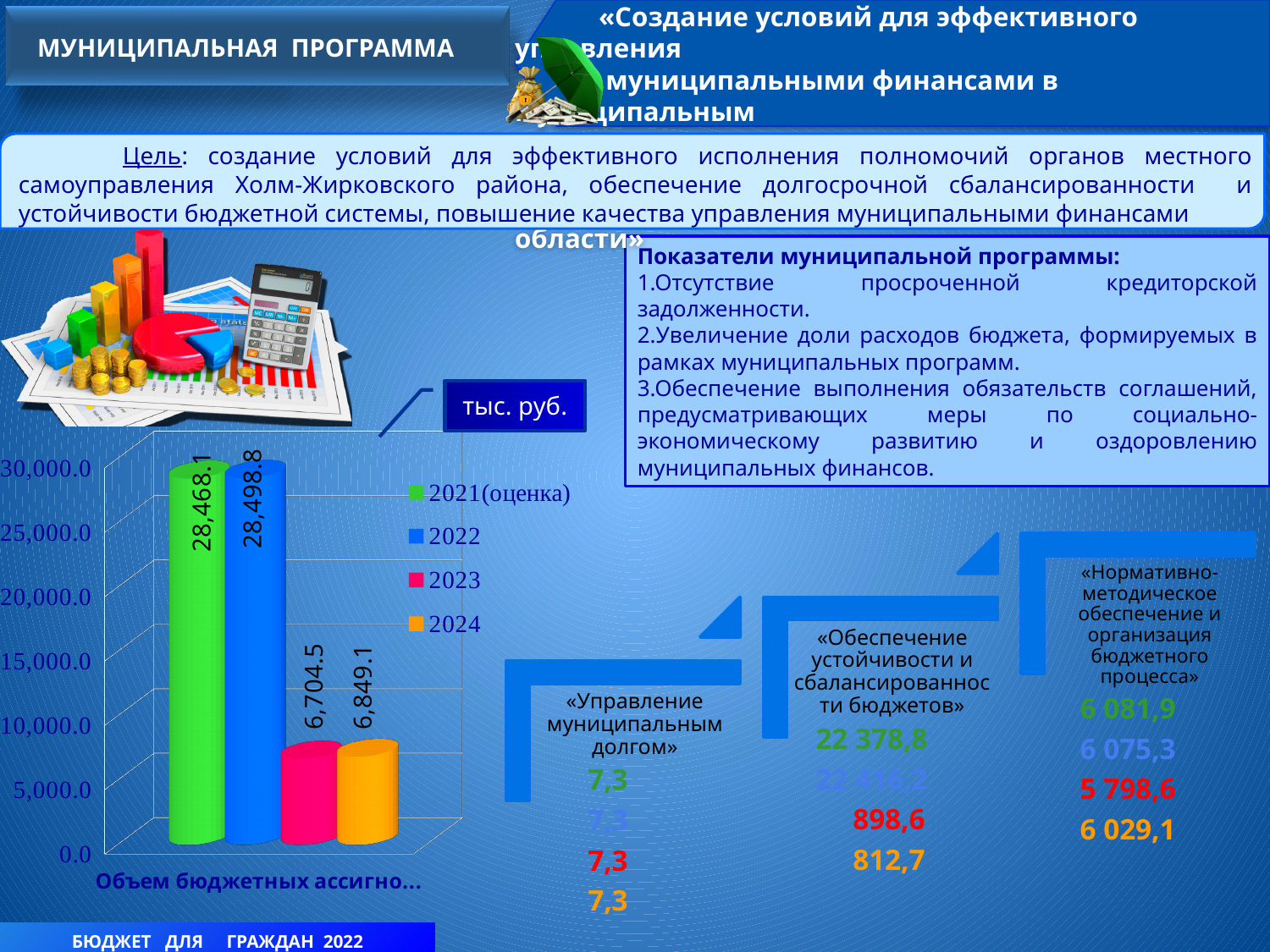
What is the value for the 2022 series in the bar chart? 28,498.8 What is the difference between the 2024 value and the 2023 value in the bar chart? 144.6 What is the difference between the 2022 value and the 2021(оценка) value in the bar chart? 30.7 How many series does the legend of the bar chart list? 4 What is the value for the 2023 series in the bar chart? 6,704.5 Which series has the highest value in the bar chart? 2022 What unit is indicated for the values in the bar chart? тыс. руб. Which series has the lowest value in the bar chart? 2023 Which is larger in the bar chart, the value for 2022 or the value for 2024? 2022 What is the value for the 2024 series in the bar chart? 6,849.1 What kind of chart is shown on the slide? bar chart What is the value for the 2021(оценка) series in the bar chart? 28,468.1